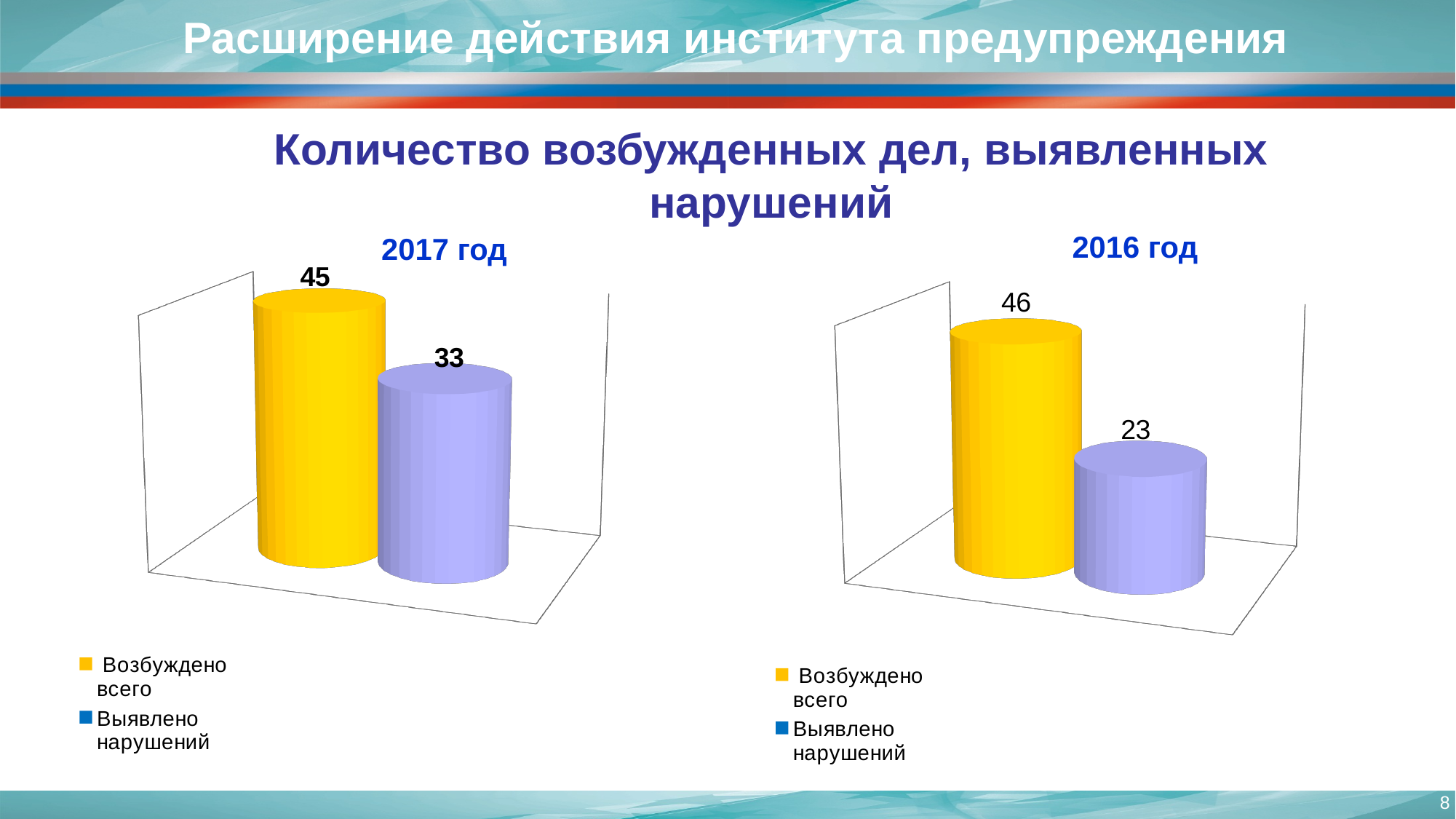
In the 2016 год chart, what is the value for Возбуждено всего? 46 In the 2017 год chart, which series has the highest value? Возбуждено всего How many series does the legend of the 2016 год chart list? 2 Which is larger: Выявлено нарушений in the 2017 год chart or Выявлено нарушений in the 2016 год chart? 2017 год In the 2017 год chart, what is the value for Выявлено нарушений? 33 In the 2016 год chart, what is the difference between Возбуждено всего and Выявлено нарушений? 23 In the 2016 год chart, what is the value for Выявлено нарушений? 23 What kind of chart is the 2017 год chart? bar chart In the 2017 год chart, what is the difference between Возбуждено всего and Выявлено нарушений? 12 In the 2017 год chart, what colour is the bar for Возбуждено всего? yellow In the 2017 год chart, what is the value for Возбуждено всего? 45 In the 2016 год chart, which series has the lowest value? Выявлено нарушений